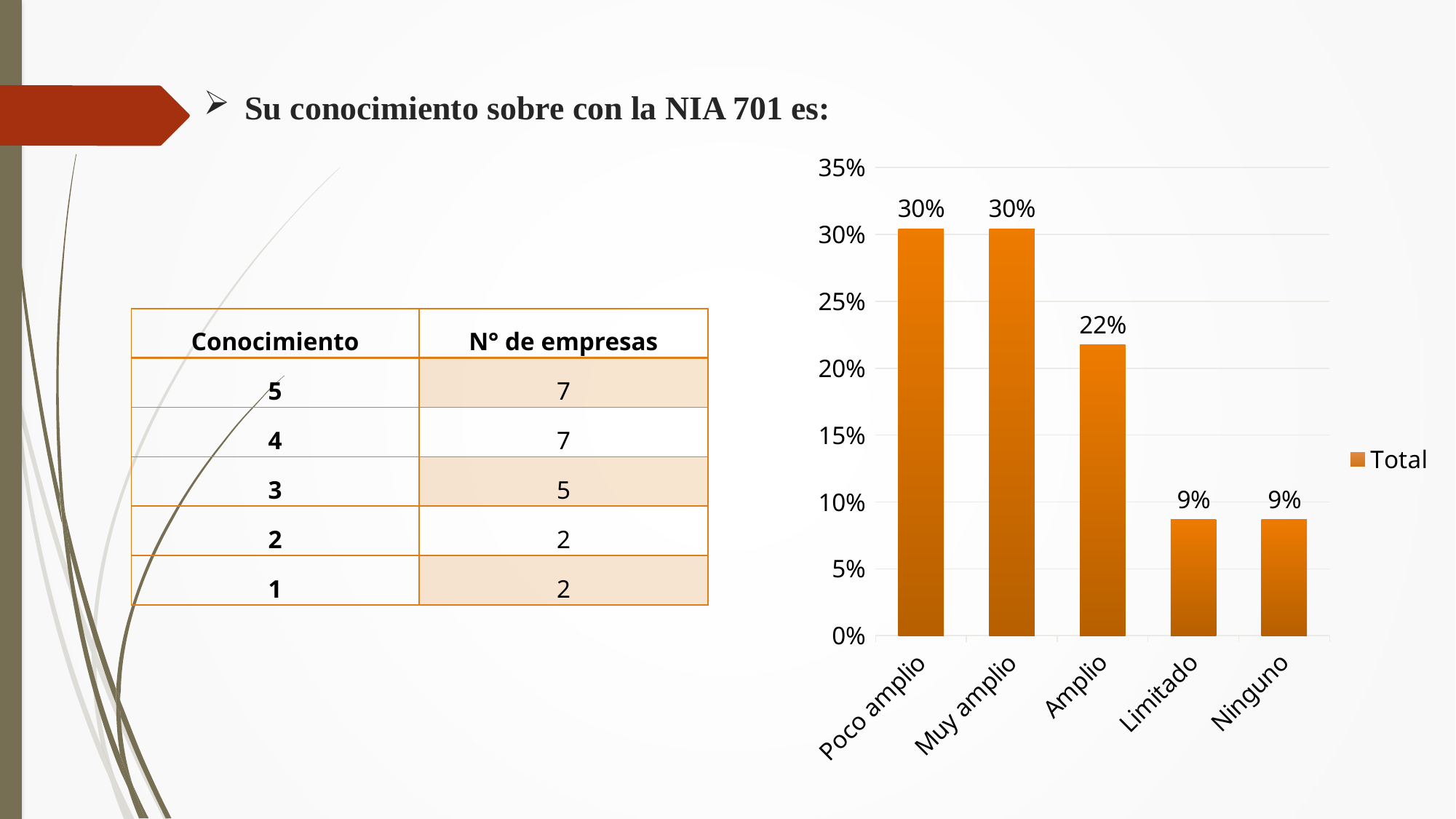
What kind of chart is shown on the slide? bar chart What is the value for Limitado? 9% What is the value for Ninguno? 9% What is the value for Muy amplio? 30% What is the difference between the values for Poco amplio and Amplio? 8% How many series does the chart legend list? 1 Which is larger, the value for Amplio or the value for Ninguno? Amplio How many categories are shown on the x axis of the chart? 5 What is the value for Amplio? 22% Is the value for Limitado greater or less than 10%? less What is the difference between the values for Amplio and Limitado? 13% Is the value for Amplio greater or less than 20%? greater